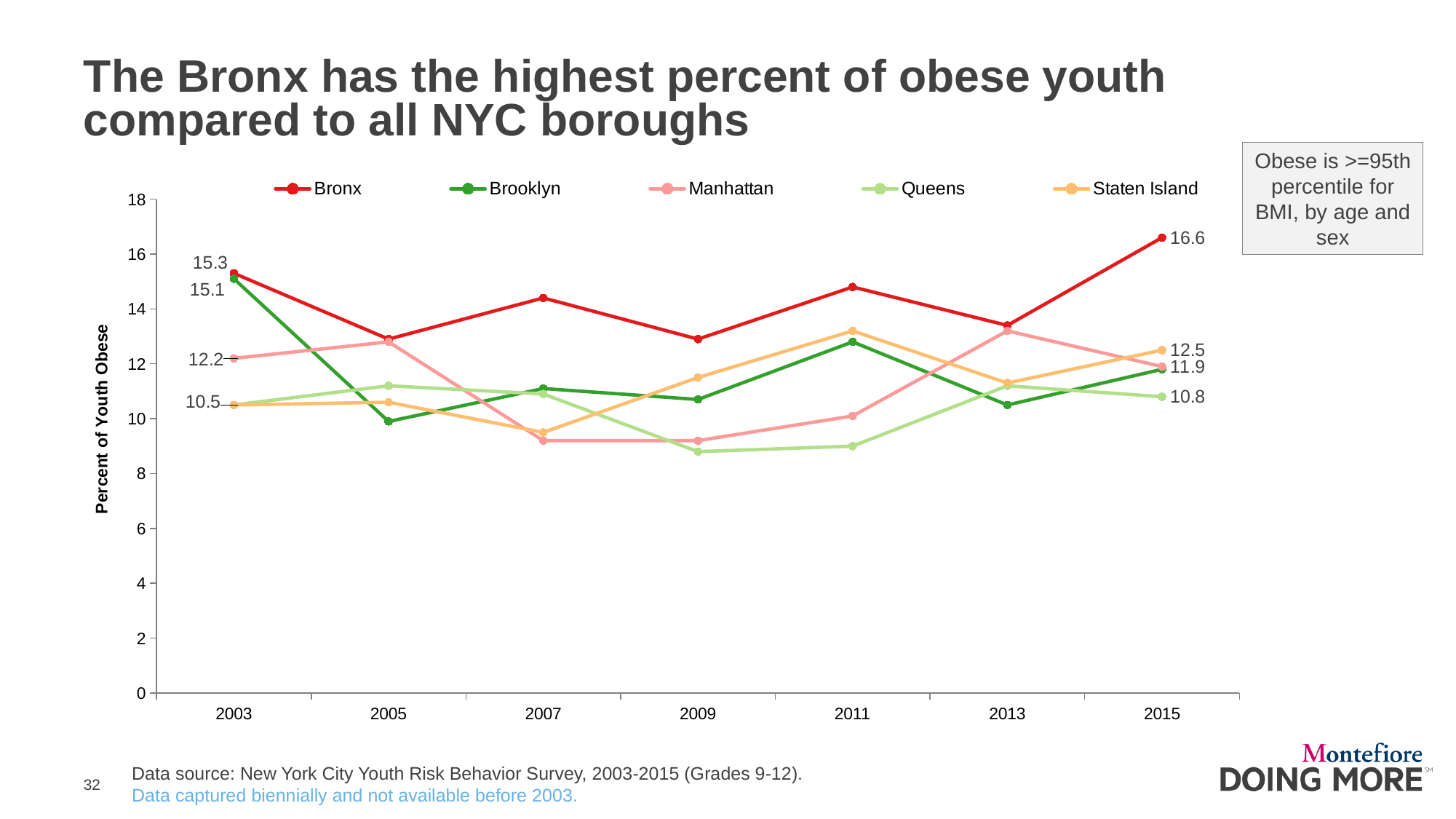
By how much did the Bronx value increase from 2003 to 2015? 1.3 Is the value for Queens in 2009 greater or less than 10? less What is the value for the Bronx in 2015? 16.6 What is the value for Manhattan in 2003? 12.2 What is the value for Brooklyn in 2003? 15.1 Which borough has the highest value in 2015? Bronx What is the value for the Bronx in 2003? 15.3 What is the value for Queens in 2015? 10.8 How many series does the legend list? 5 What is the value for Staten Island in 2015? 12.5 How many years are shown on the x axis? 7 What kind of chart is shown on the slide? line chart